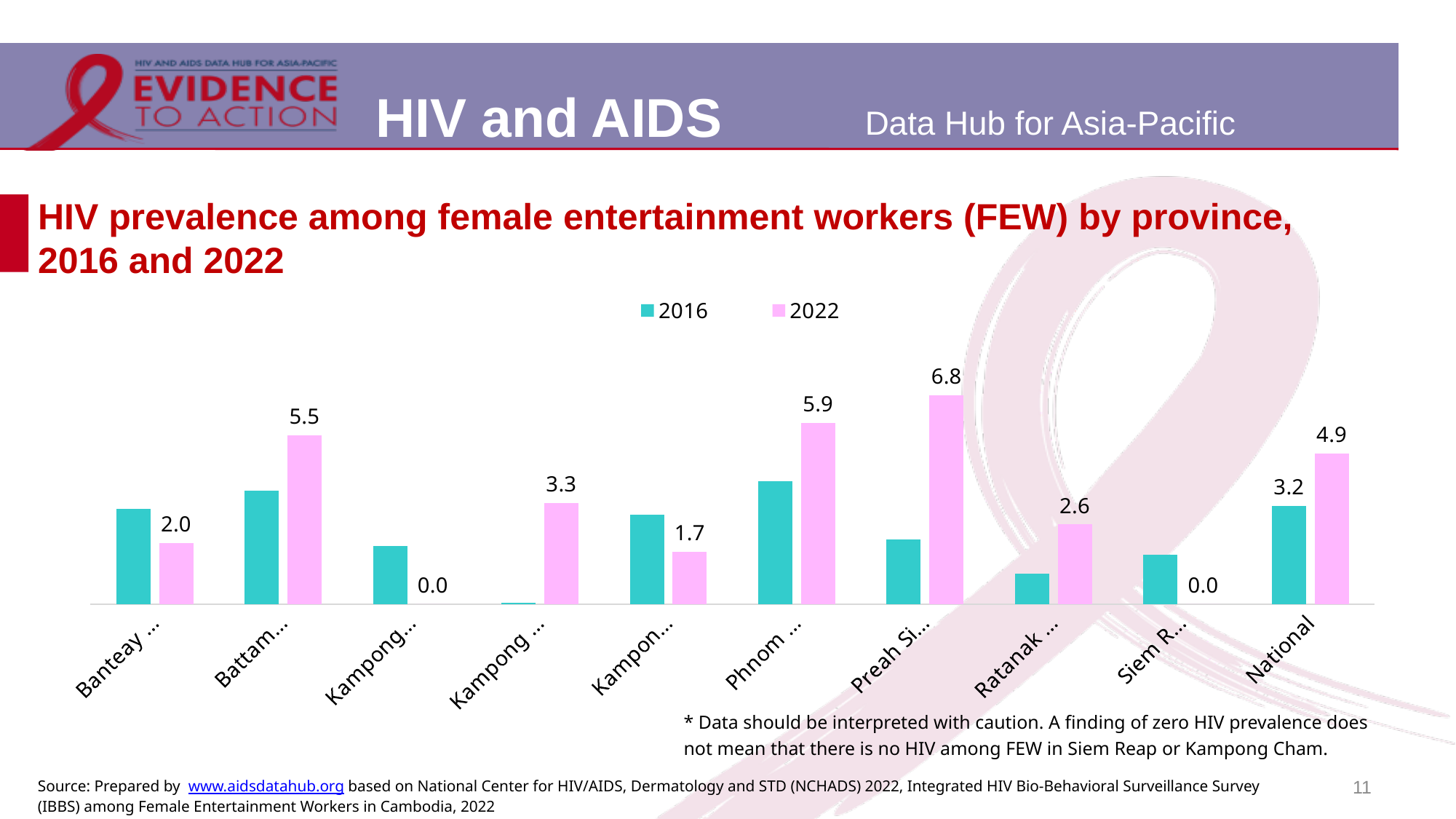
How many series does the legend list? 2 What is the 2022 HIV prevalence value for National? 4.9 What is the 2016 HIV prevalence value for National? 3.2 How many categories are shown along the x axis? 10 What is the highest 2022 value labelled on the chart? 6.8 How many categories have a 2022 value of 0.0? 2 What is the lowest 2022 value labelled on the chart? 0.0 What are the two series named in the legend? 2016 and 2022 By how much did the National value increase from 2016 to 2022? 1.7 What is the title of the chart? HIV prevalence among female entertainment workers (FEW) by province, 2016 and 2022 What kind of chart is shown on the slide? bar chart For National, which year has the larger value, 2016 or 2022? 2022